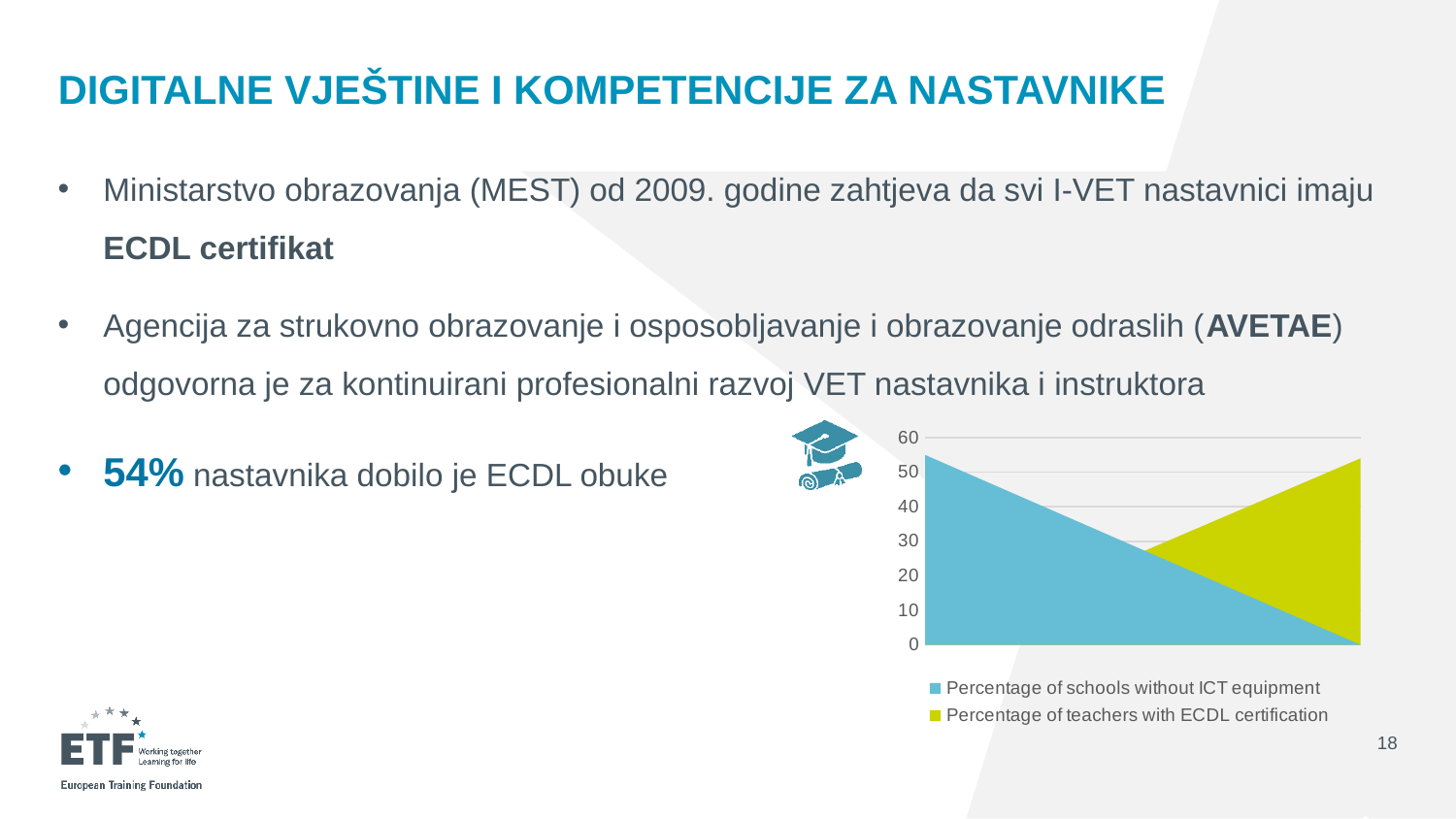
Which colour represents 'Percentage of teachers with ECDL certification' in the chart? Yellow-green Is the starting value (left end) of 'Percentage of teachers with ECDL certification' greater or less than 10? less Is the ending value (right end) of 'Percentage of schools without ICT equipment' greater or less than 10? less Does the 'Percentage of teachers with ECDL certification' series rise or fall from left to right along the x axis? Rise What is the first series listed in the chart legend? Percentage of schools without ICT equipment What is the highest value shown on the chart's vertical axis? 60 Does the 'Percentage of schools without ICT equipment' series rise or fall from left to right along the x axis? Fall What kind of chart is shown on the slide? Area chart Is the starting value (left end) of 'Percentage of schools without ICT equipment' greater or less than 40? greater How many series does the chart legend list? 2